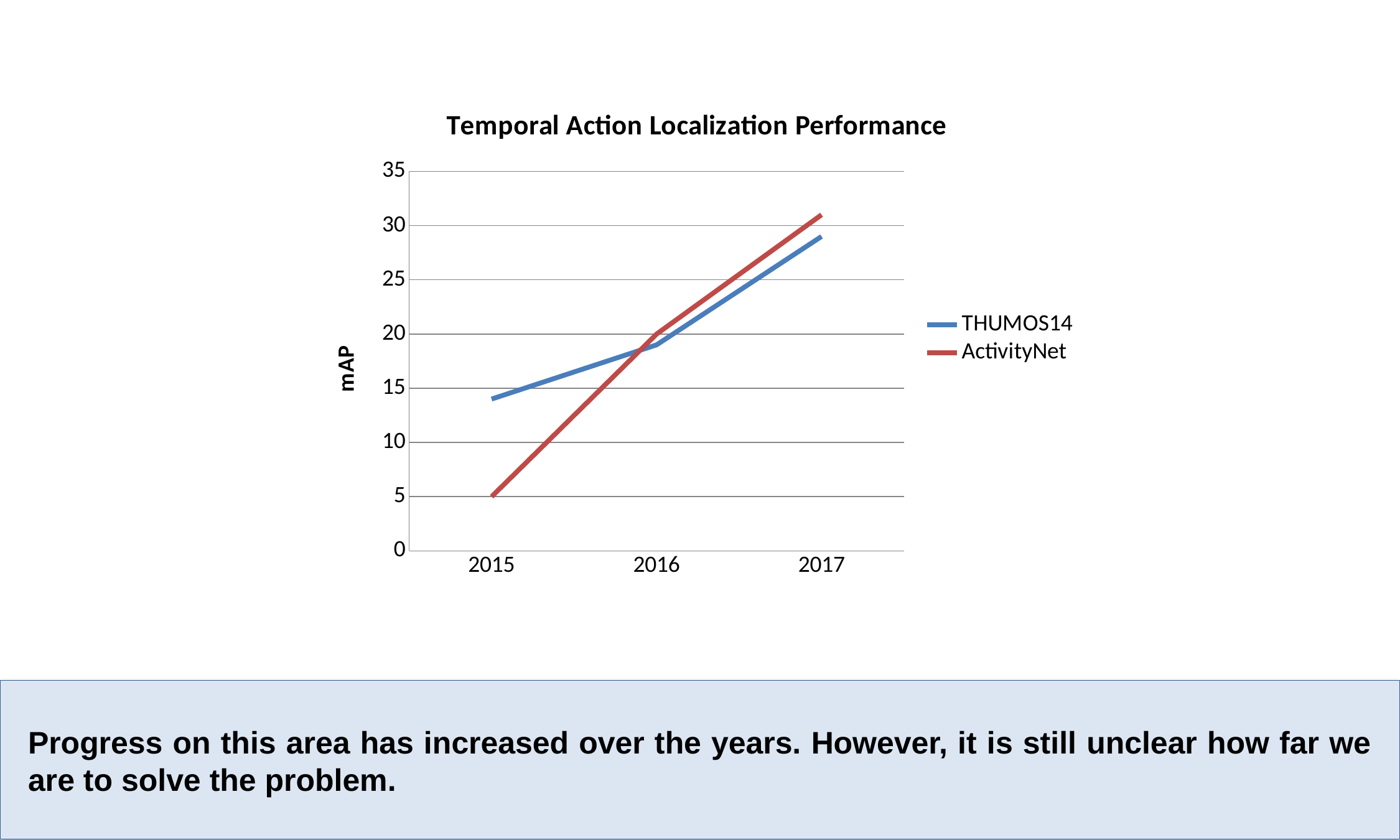
Is the ActivityNet value for 2015 greater or less than 10? less What is the label on the y axis? mAP In which year is the THUMOS14 value lowest? 2015 In 2015, which series has the larger value, THUMOS14 or ActivityNet? THUMOS14 In which year is the ActivityNet value highest? 2017 How many years are plotted along the x axis? 3 Does the THUMOS14 line rise or fall from 2015 to 2017? rise Does the ActivityNet line rise or fall from 2015 to 2017? rise How many series does the legend list? 2 What kind of chart is shown on the slide? line chart Is the THUMOS14 value for 2017 greater or less than 25? greater What is the title of the chart? Temporal Action Localization Performance